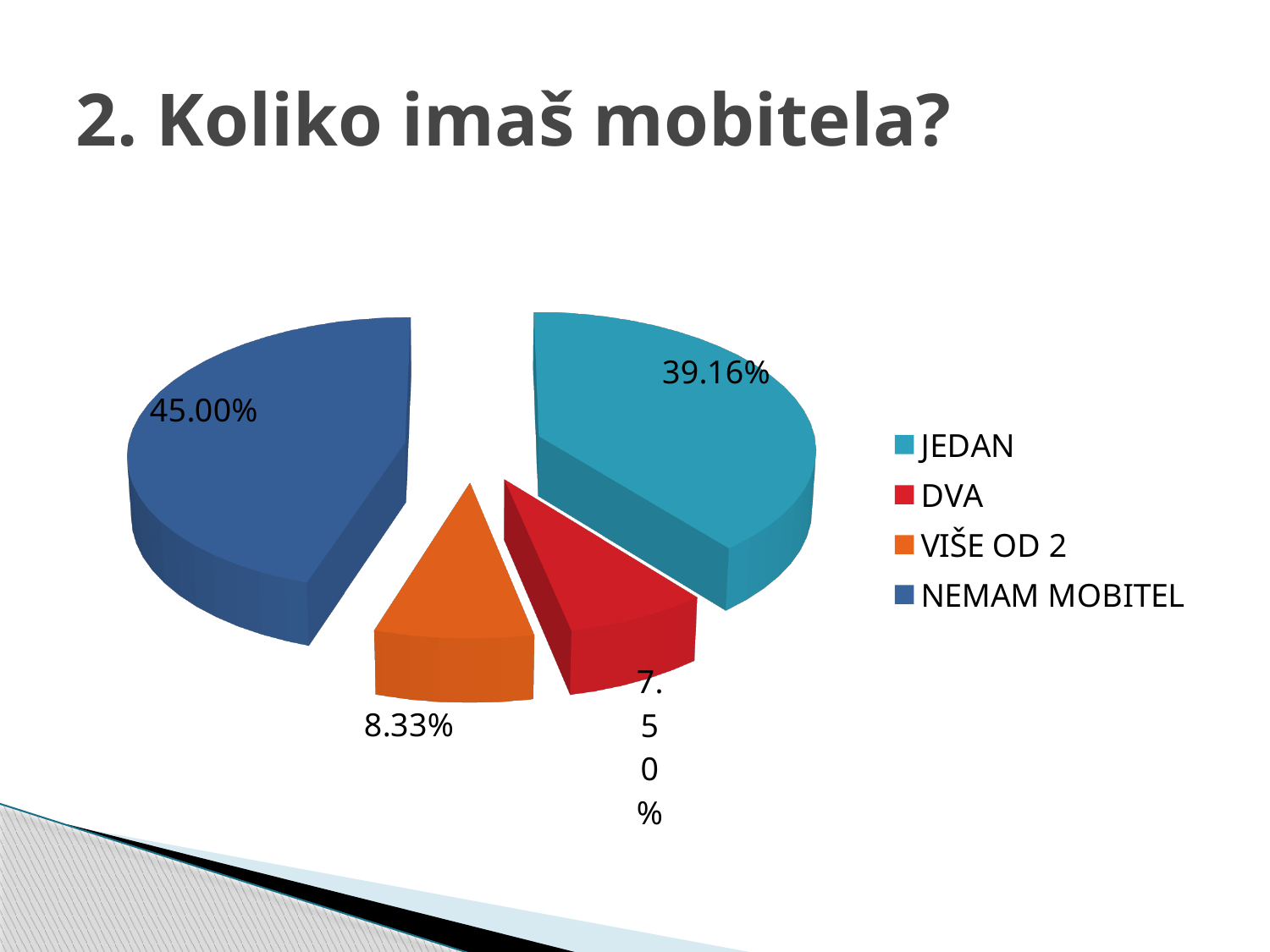
What is the difference between the shares of NEMAM MOBITEL and JEDAN? 5.84% What share of the pie does JEDAN have? 39.16% What share of the pie does DVA have? 7.50% What is the title of the slide containing the chart? 2. Koliko imaš mobitela? What share of the pie does NEMAM MOBITEL have? 45.00% What kind of chart is shown on the slide? pie chart What colour is the slice for VIŠE OD 2? orange How many categories does the pie chart have? 4 Which category has the smallest slice of the pie? DVA Which category has the largest slice of the pie? NEMAM MOBITEL Which is larger, the share for VIŠE OD 2 or the share for DVA? VIŠE OD 2